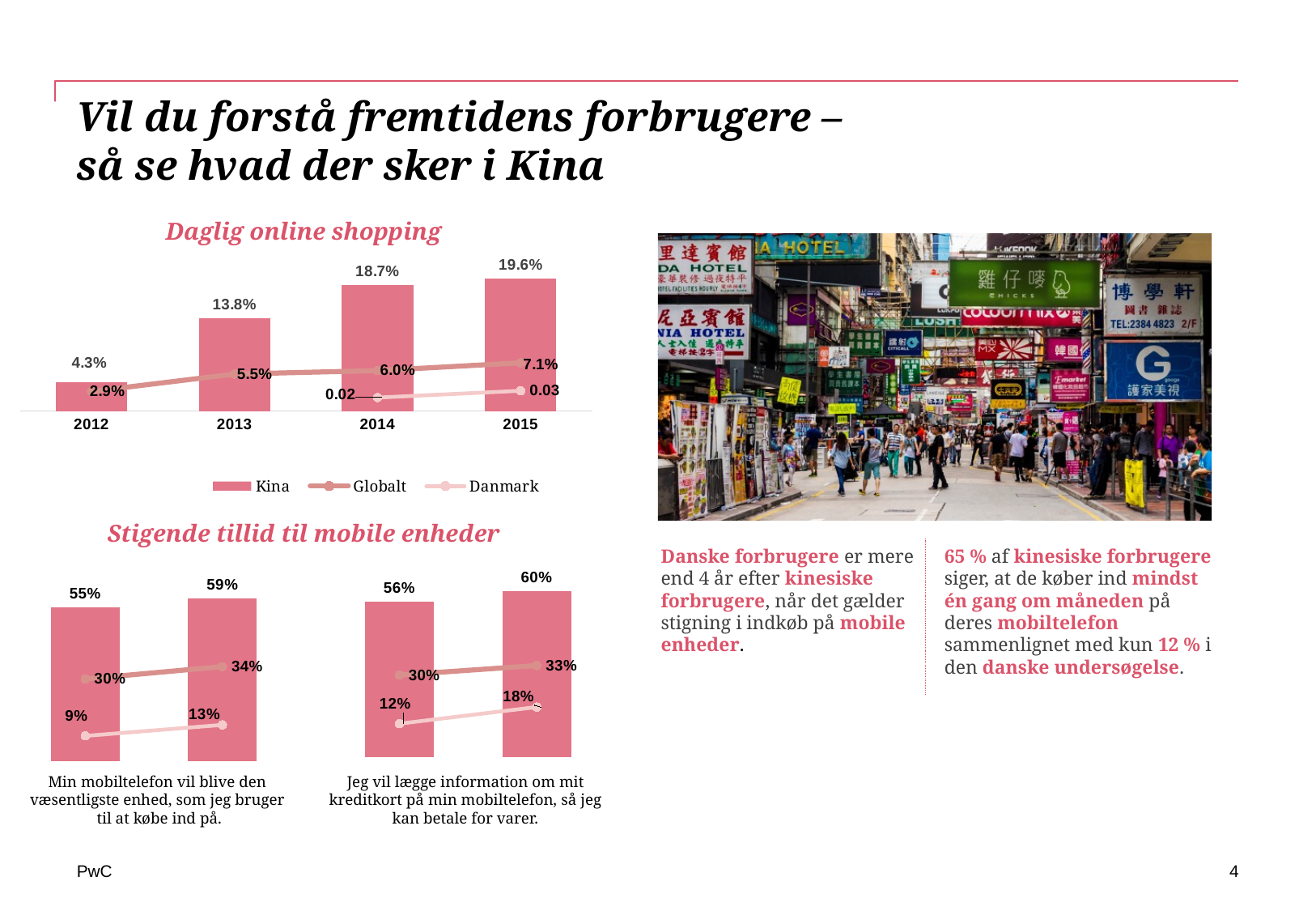
In the 'Daglig online shopping' chart, what is the value for Danmark in 2014? 0.02 In the chart captioned 'Min mobiltelefon vil blive den væsentligste enhed, som jeg bruger til at købe ind på', what is the value of the right-hand bar? 59% In the 'Daglig online shopping' chart, what is the difference between the Kina values for 2013 and 2012? 9.5% In the 'Daglig online shopping' chart, do the Kina values rise or fall from 2012 to 2015? rise In the chart captioned 'Jeg vil lægge information om mit kreditkort på min mobiltelefon, så jeg kan betale for varer', what is the difference between the two bar values? 4% In the 'Daglig online shopping' chart, which year has the highest value for Kina? 2015 In the 'Daglig online shopping' chart, how many series does the legend list? 3 In the 'Daglig online shopping' chart, what is the value for Kina in 2015? 19.6% In the 'Daglig online shopping' chart, which year has the lowest value for Globalt? 2012 In the 'Daglig online shopping' chart, which series is drawn as bars? Kina In the 'Daglig online shopping' chart, what is the value for Globalt in 2013? 5.5% In the 'Daglig online shopping' chart, how many years are shown on the x axis? 4